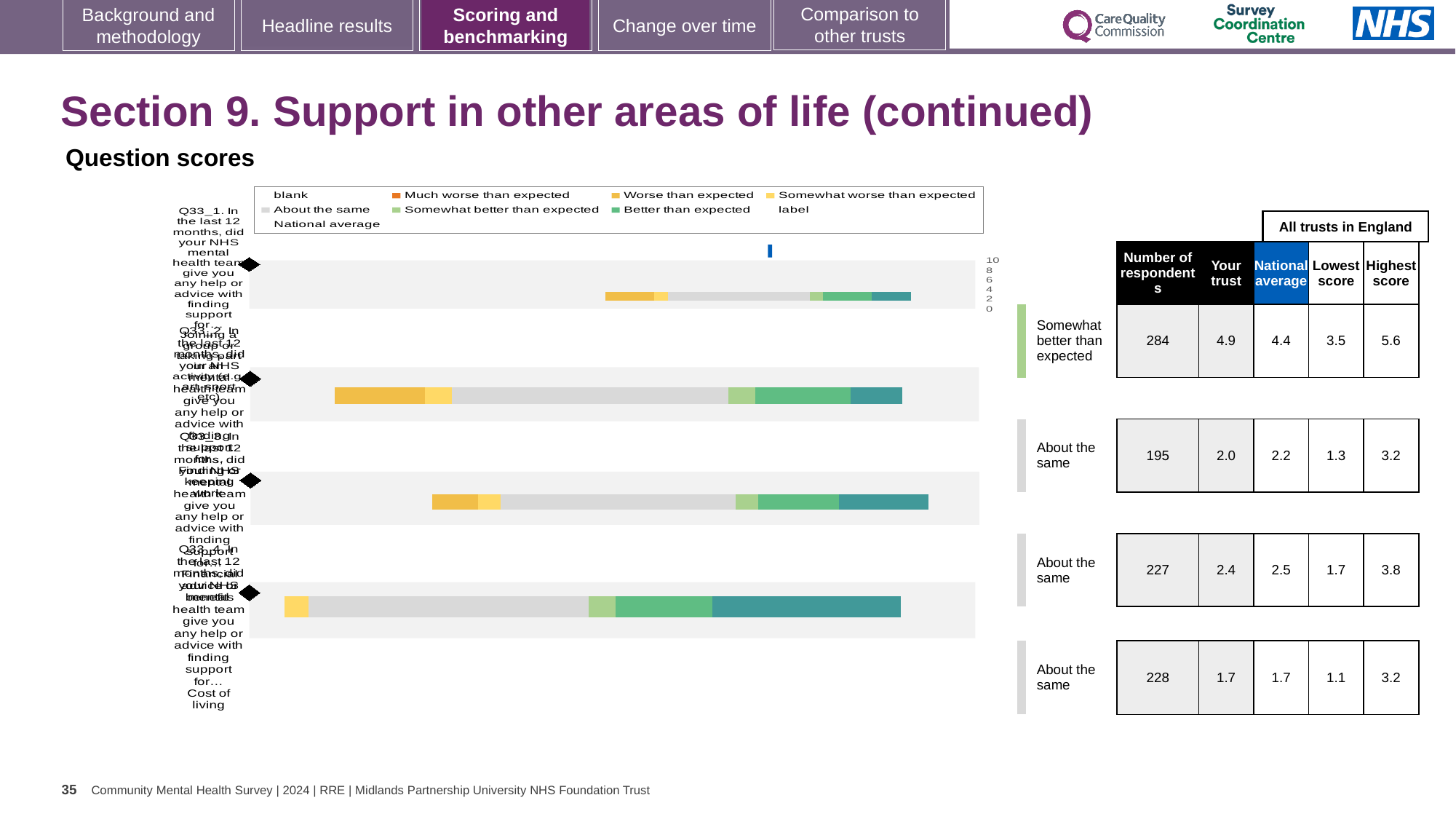
What is the highest score among all trusts in England for Q33_4? 3.2 Which question has the largest number of respondents? Q33_1 Which question's trust score is categorised as 'Somewhat better than expected'? Q33_1 What is the lowest score among all trusts in England for Q33_3? 1.7 For Q33_1, which is larger: the 'Your trust' score or the national average? Your trust What kind of chart is used to show the question scores on this slide? bar chart What is the heading printed above the question scores chart? Question scores How many respondents are listed for Q33_1? 284 How many questions (bars) are plotted in the question scores chart? 4 What is the 'Your trust' score for Q33_1? 4.9 What is the national average score for Q33_2? 2.2 What is the difference between the 'Your trust' score and the national average for Q33_1? 0.5